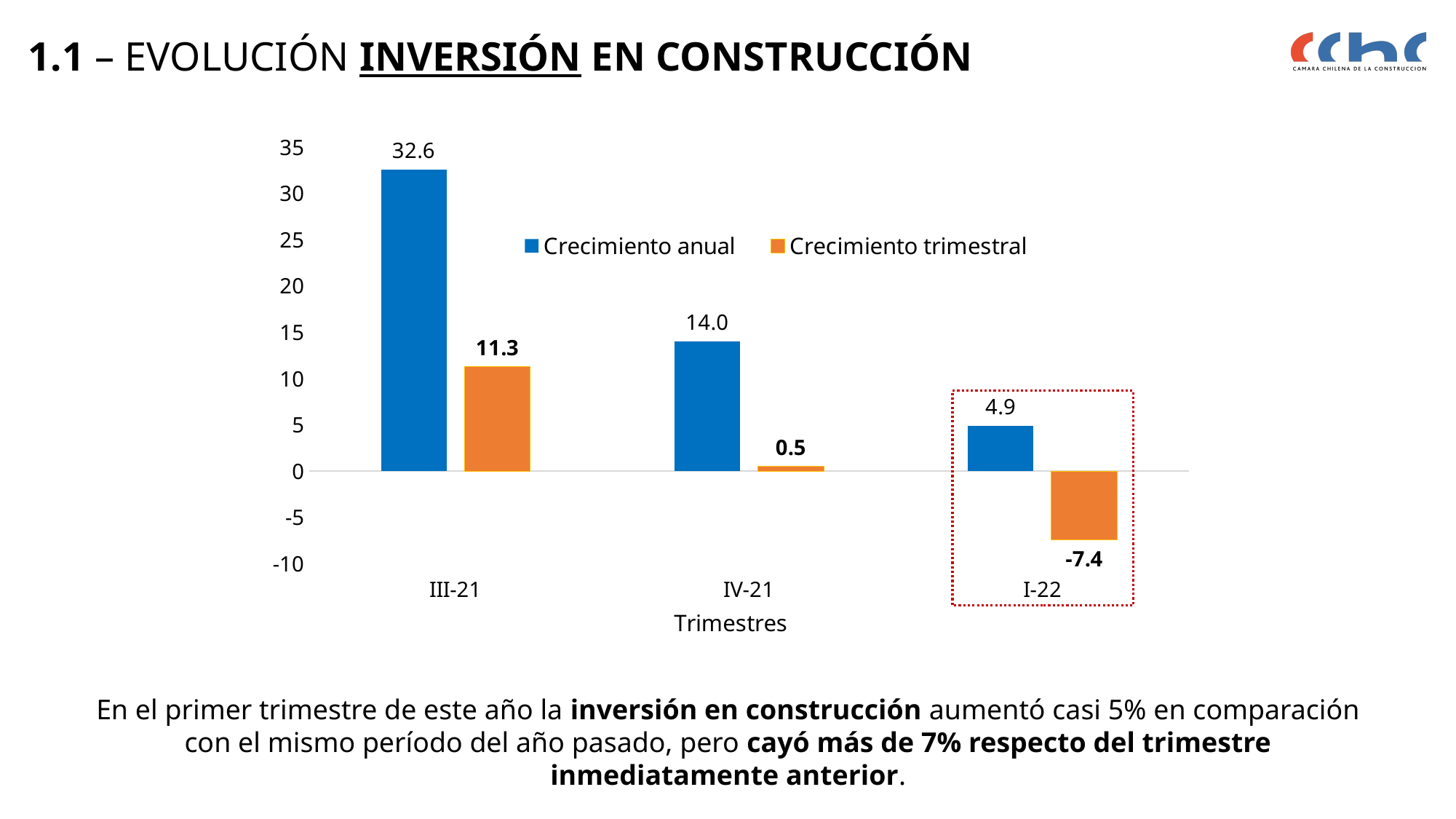
What is the value of Crecimiento anual for III-21? 32.6 Does the Crecimiento anual series rise or fall from III-21 to I-22? Fall How many series does the legend list? 2 Which is larger for IV-21: Crecimiento anual or Crecimiento trimestral? Crecimiento anual How many quarters are shown on the x axis? 3 Which quarter has the highest Crecimiento anual value? III-21 What kind of chart is shown on the slide? Bar chart Which quarter has the lowest Crecimiento trimestral value? I-22 What is the value of Crecimiento trimestral for I-22? -7.4 What is the value of Crecimiento anual for I-22? 4.9 What is the difference between Crecimiento anual and Crecimiento trimestral for III-21? 21.3 What is the value of Crecimiento trimestral for IV-21? 0.5